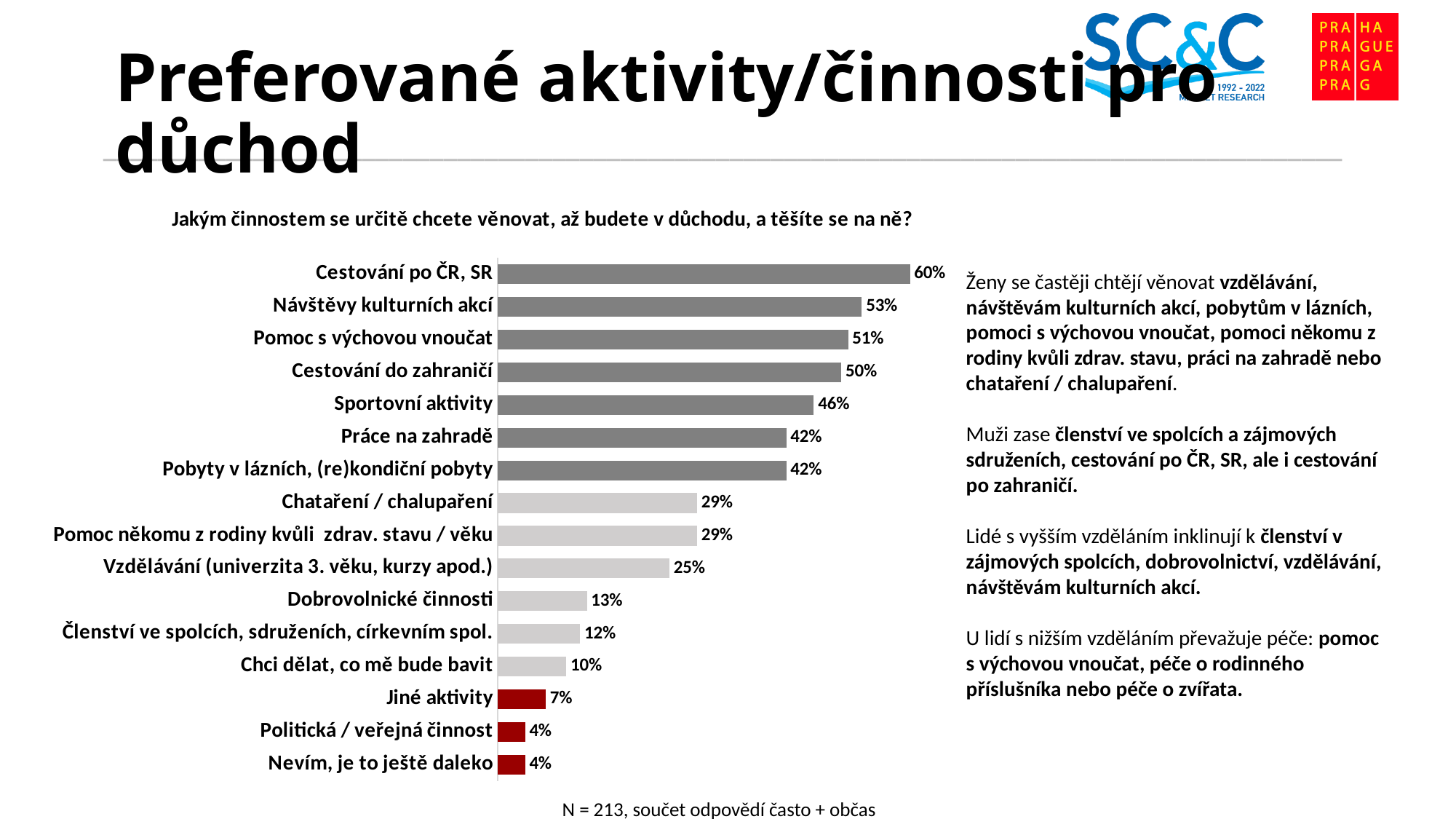
How many categories are shown in the chart? 16 Which is larger, "Jiné aktivity" or "Politická / veřejná činnost"? Jiné aktivity Which category has the highest value? Cestování po ČR, SR Which is larger, "Práce na zahradě" or "Chataření / chalupaření"? Práce na zahradě What is the value for "Sportovní aktivity"? 46% What is the value for "Cestování po ČR, SR"? 60% What is the difference between "Cestování po ČR, SR" and "Chci dělat, co mě bude bavit"? 50% What is the difference between "Návštěvy kulturních akcí" and "Cestování do zahraničí"? 3% What is the sample size (N) stated below the chart? N = 213 What is the value for "Dobrovolnické činnosti"? 13% What kind of chart is shown on the slide? Bar chart What is the value for "Vzdělávání (univerzita 3. věku, kurzy apod.)"? 25%